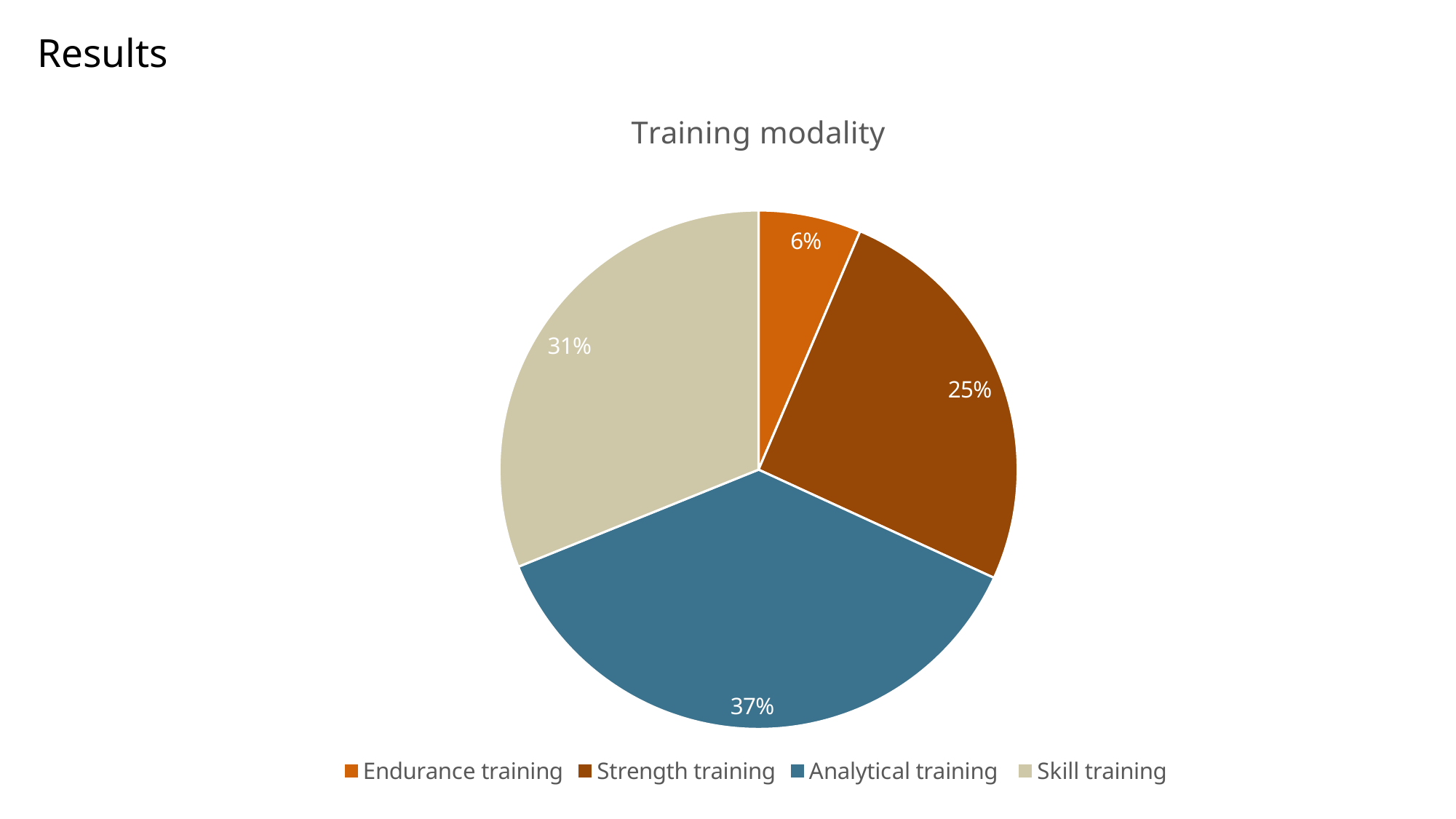
Which training modality has the largest share? Analytical training How many slices does the pie chart have? 4 What is the difference in percentage points between Analytical training and Strength training? 12 Which colour represents Endurance training in the legend? orange What kind of chart is shown on the slide? pie chart What is the title of the chart? Training modality What share of the pie does Analytical training have? 37% Which is larger, the share for Skill training or the share for Strength training? Skill training What share of the pie does Strength training have? 25% Which training modality has the smallest share? Endurance training What share of the pie does Endurance training have? 6%